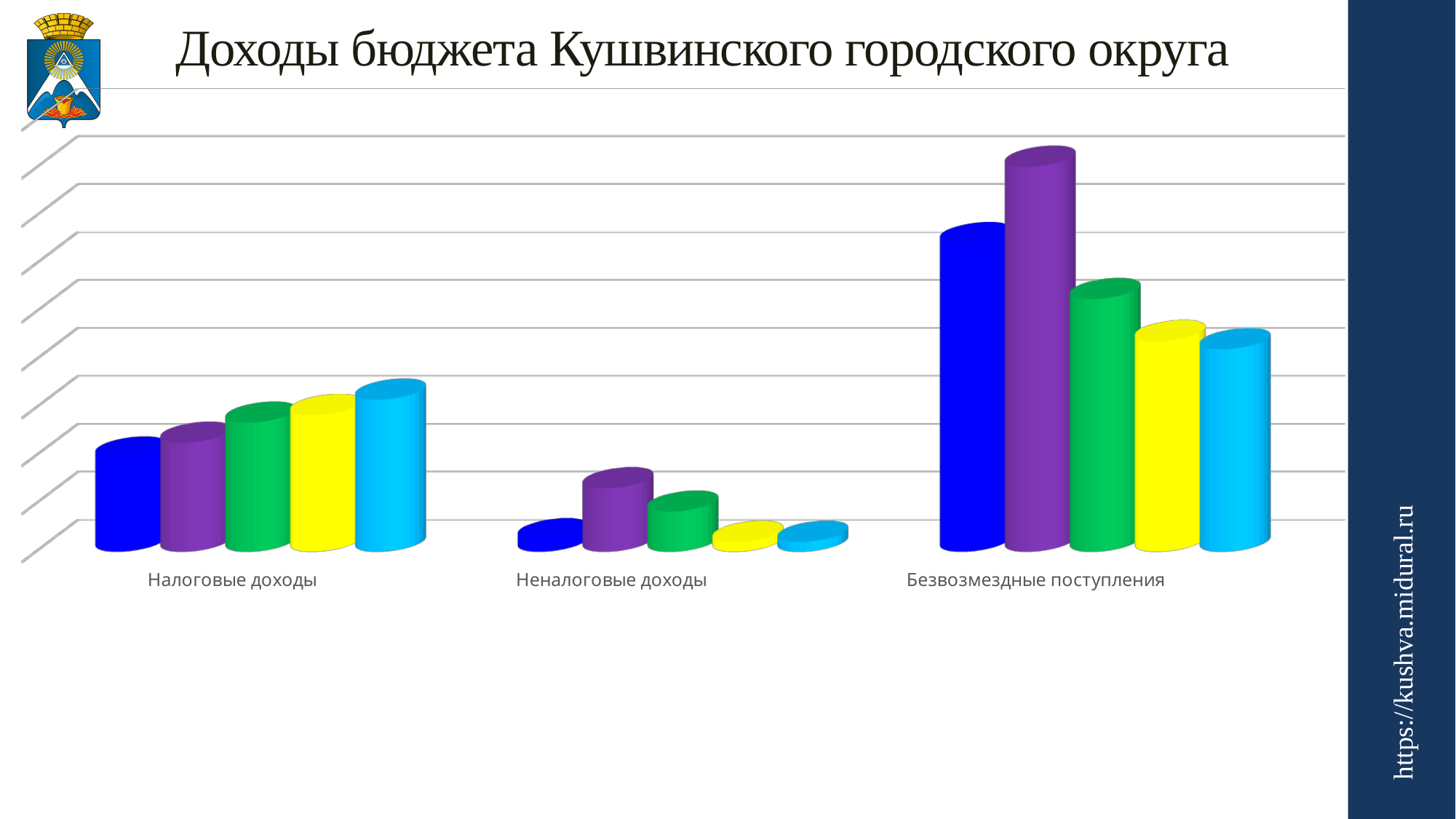
For the purple bars, which is larger: Налоговые доходы or Неналоговые доходы? Налоговые доходы Within the category Безвозмездные поступления, which colour bar is the tallest? purple Within the category Налоговые доходы, which colour bar is the tallest? light blue For the dark blue bars, which is larger: Налоговые доходы or Безвозмездные поступления? Безвозмездные поступления What kind of chart is shown on the slide? bar chart How many categories are shown on the x axis of the chart? 3 Within the category Налоговые доходы, do the bars rise or fall from left to right? rise What is the title of the slide with the chart? Доходы бюджета Кушвинского городского округа Which category contains the tallest bar in the chart? Безвозмездные поступления How many bars are plotted for each category in the chart? 5 Which category has the lowest bars overall in the chart? Неналоговые доходы